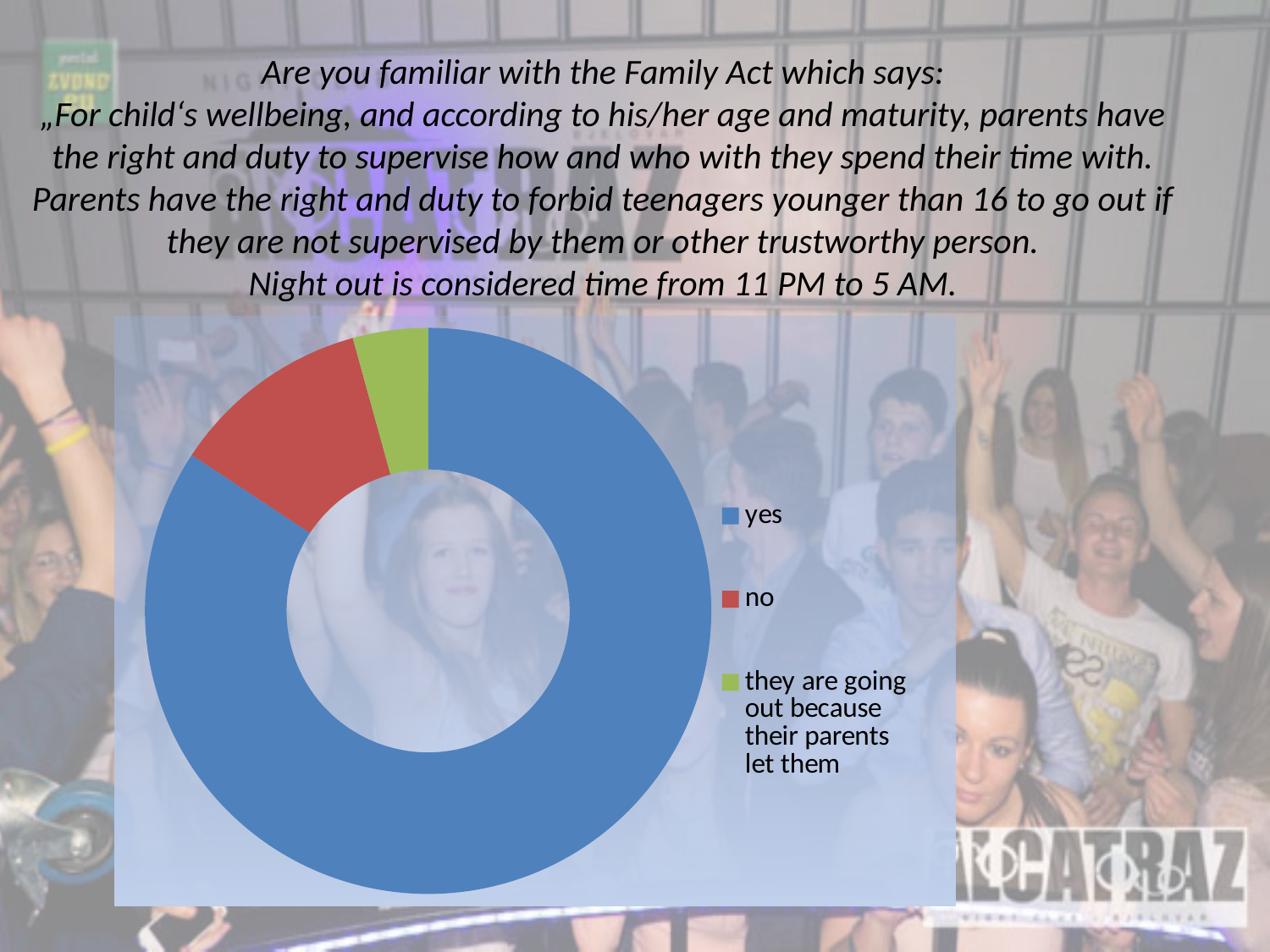
What kind of chart is shown on the slide? doughnut chart What colour represents the "no" category in the chart? red Which category has the largest share of the chart? yes Is the share for "yes" greater or less than half of the chart? greater Which is larger, the share for "no" or the share for "they are going out because their parents let them"? no Which category has the smallest share of the chart? they are going out because their parents let them How many categories does the chart show? 3 What colour represents the "yes" category in the chart? blue Which is larger, the share for "yes" or the share for "no"? yes Is the share for "no" greater or less than a quarter of the chart? less